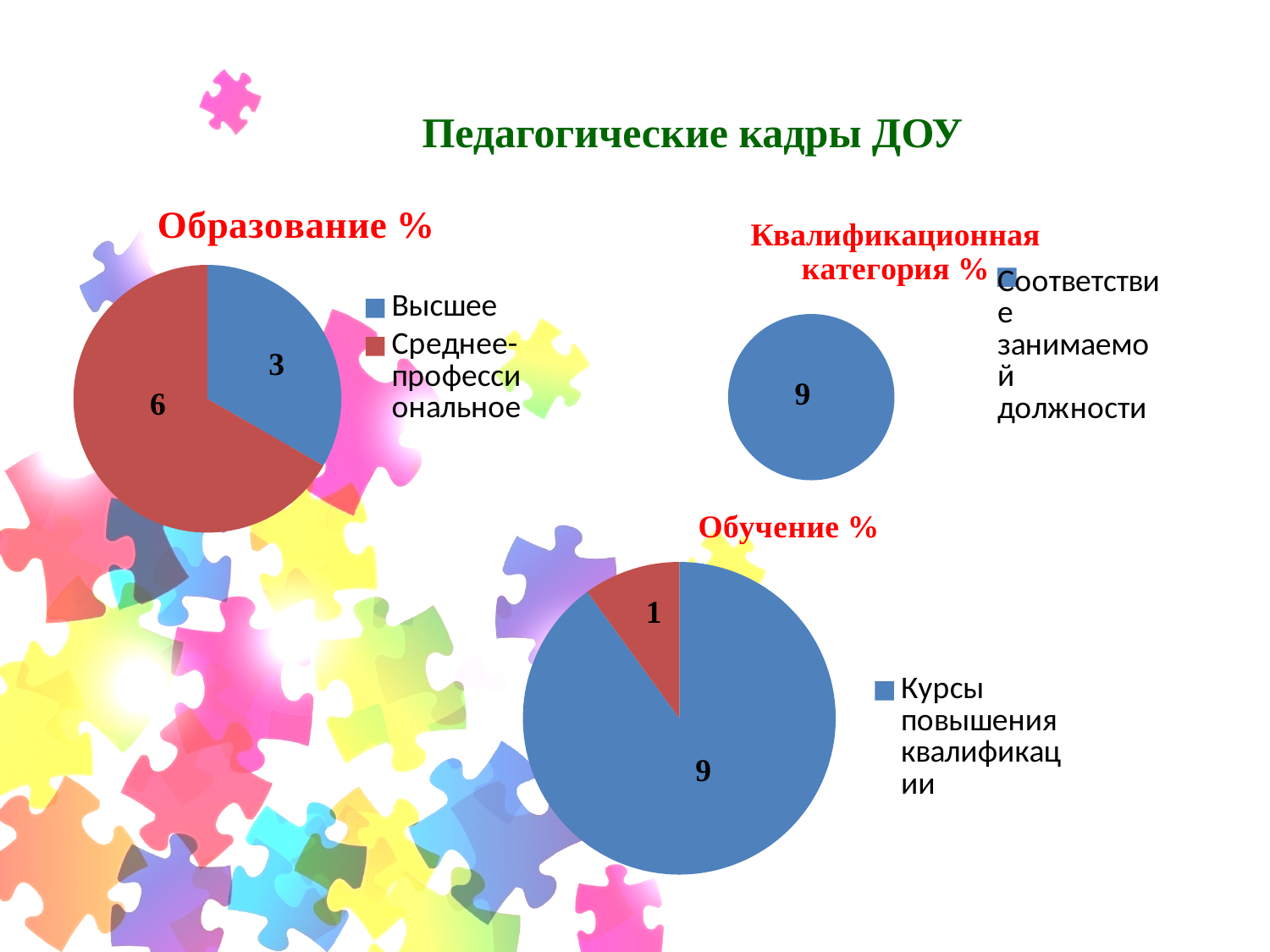
In the "Образование %" chart, what is the difference between Среднее-профессиональное and Высшее? 3 In the "Обучение %" chart, what is the value of the smallest slice? 1 In the "Обучение %" chart, what is the value of the largest slice? 9 What kind of chart is the "Образование %" chart? Pie chart In the "Образование %" chart, which category has the smallest slice? Высшее In the "Квалификационная категория %" chart, what value is shown for Соответствие занимаемой должности? 9 What legend entry is shown for the "Обучение %" chart? Курсы повышения квалификации In the "Образование %" chart, which category has the largest slice? Среднее-профессиональное In the "Образование %" chart, which is larger: Высшее or Среднее-профессиональное? Среднее-профессиональное In the "Образование %" chart, what is the value for Высшее? 3 How many entries does the legend of the "Образование %" chart list? 2 In the "Образование %" chart, what is the value for Среднее-профессиональное? 6